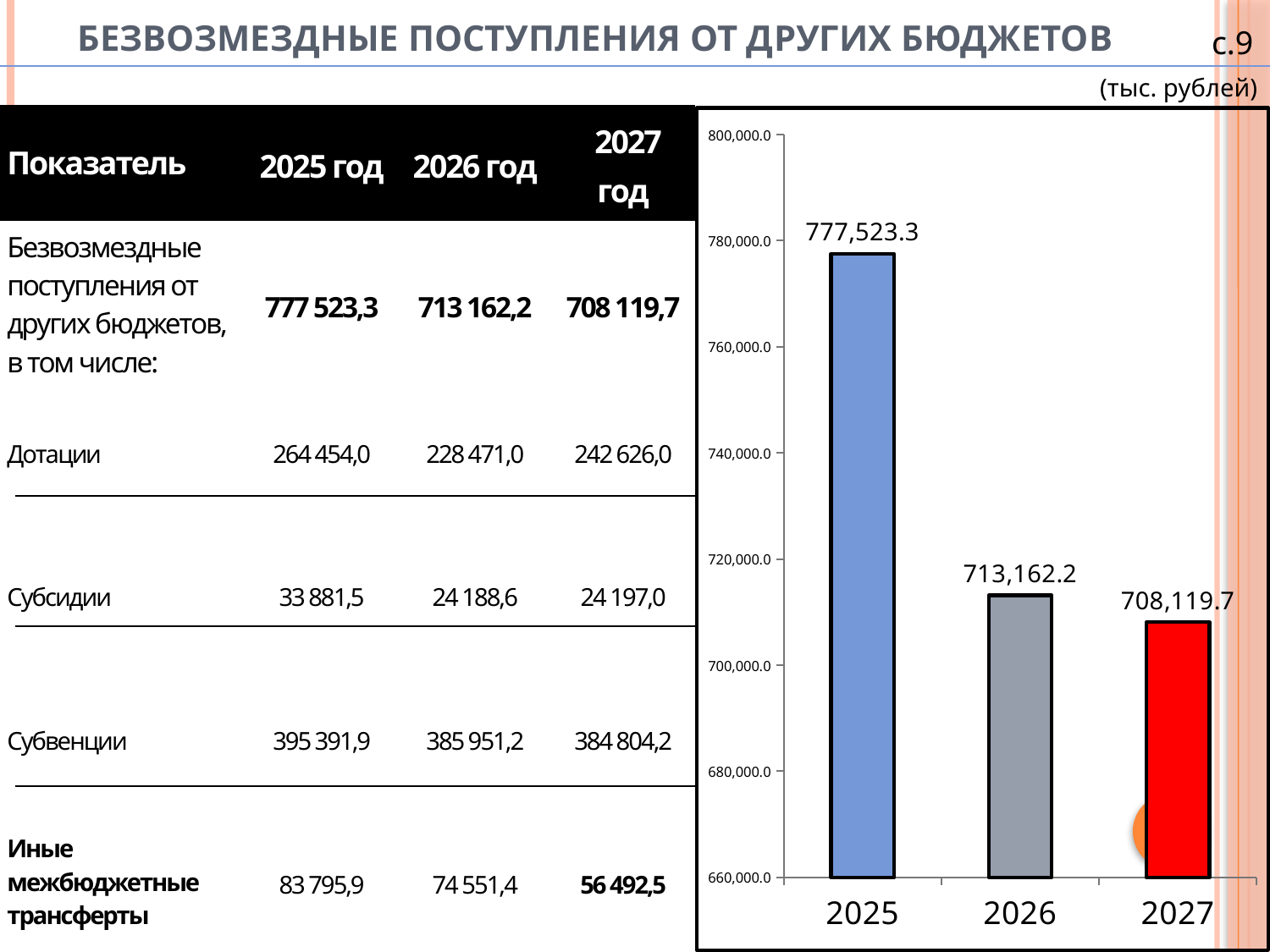
Do the values rise or fall from 2025 to 2027 on the chart? fall Which year has the highest value on the chart? 2025 Which year has the lowest value on the chart? 2027 What kind of chart is shown on the slide? bar chart What is the value shown for 2027 on the chart? 708,119.7 What is the value shown for 2025 on the chart? 777,523.3 What is the difference between the values for 2026 and 2027 on the chart? 5,042.5 Is the value for 2027 greater or less than 720,000.0? less What is the value shown for 2026 on the chart? 713,162.2 How many bars are plotted on the chart? 3 What is the difference between the values for 2025 and 2026 on the chart? 64,361.1 Which is larger on the chart, the value for 2026 or the value for 2027? 2026